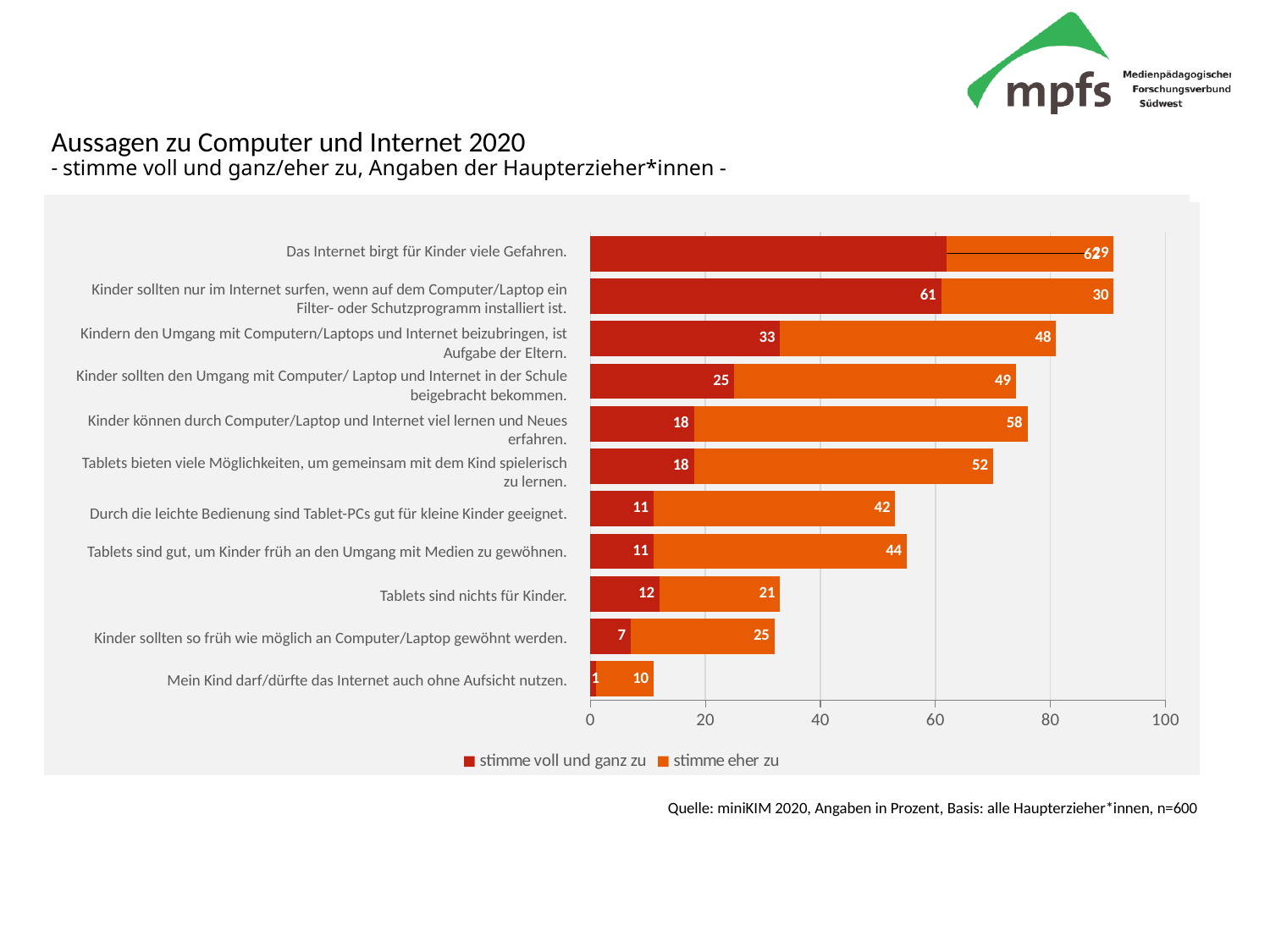
What is the value for "stimme eher zu" for the statement "Mein Kind darf/dürfte das Internet auch ohne Aufsicht nutzen."? 10 Which statement has the highest value for "stimme eher zu"? Kinder können durch Computer/Laptop und Internet viel lernen und Neues erfahren. What is the difference between the "stimme eher zu" values for "Kindern den Umgang mit Computern/Laptops und Internet beizubringen, ist Aufgabe der Eltern." and "Tablets sind nichts für Kinder."? 27 How many statements are shown in the chart? 11 What kind of chart is shown on the slide? Stacked bar chart What is the value for "stimme voll und ganz zu" for the statement "Kinder sollten nur im Internet surfen, wenn auf dem Computer/Laptop ein Filter- oder Schutzprogramm installiert ist."? 61 Which statement has the lowest value for "stimme voll und ganz zu"? Mein Kind darf/dürfte das Internet auch ohne Aufsicht nutzen. What is the value for "stimme eher zu" for the statement "Kinder können durch Computer/Laptop und Internet viel lernen und Neues erfahren."? 58 What is the total of the stacked bar for "Kinder sollten nur im Internet surfen, wenn auf dem Computer/Laptop ein Filter- oder Schutzprogramm installiert ist."? 91 How many series does the legend list? 2 What is the value for "stimme voll und ganz zu" for the statement "Tablets sind nichts für Kinder."? 12 Which is larger: the "stimme voll und ganz zu" value for "Kinder sollten den Umgang mit Computer/ Laptop und Internet in der Schule beigebracht bekommen." or for "Kinder sollten so früh wie möglich an Computer/Laptop gewöhnt werden."? Kinder sollten den Umgang mit Computer/ Laptop und Internet in der Schule beigebracht bekommen.